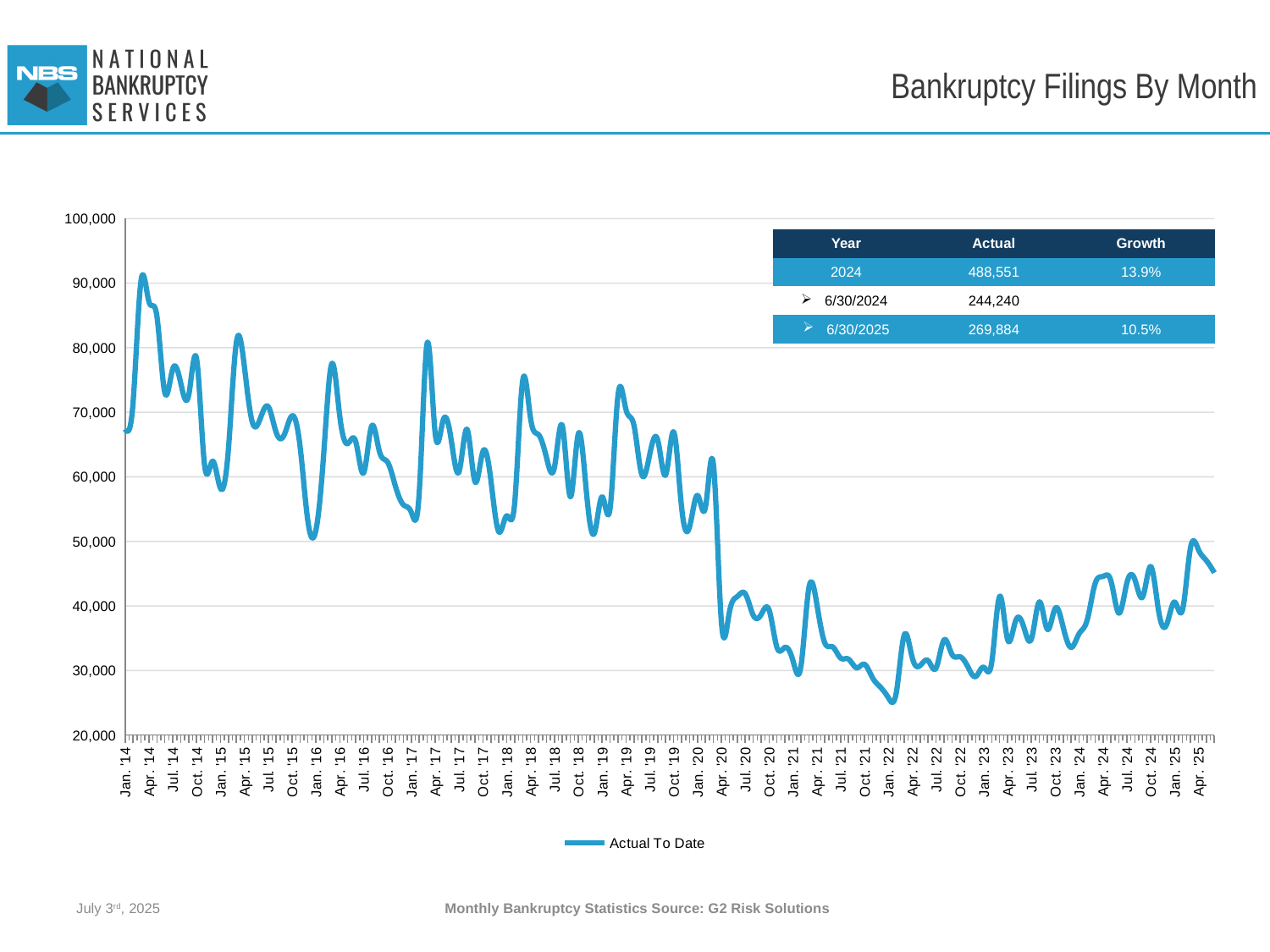
According to the table on the chart, what is the Growth for 6/30/2025? 10.5% How many series does the legend list? 1 What kind of chart is shown on the slide? Line chart Is the value for Jan. '22 greater or less than 30,000? less Is the value for Jan. '14 greater or less than 60,000? greater According to the table on the chart, what is the Actual value for 2024? 488,551 Is the peak value in early 2014 greater or less than 80,000? greater Around which month does the line reach its highest value? Mar. '14 What is the title of the chart? Bankruptcy Filings By Month Around which month does the line reach its lowest value? Jan. '22 Overall, do the values rise or fall from Jan. '14 to Jan. '22? fall What is the name of the series shown in the legend? Actual To Date